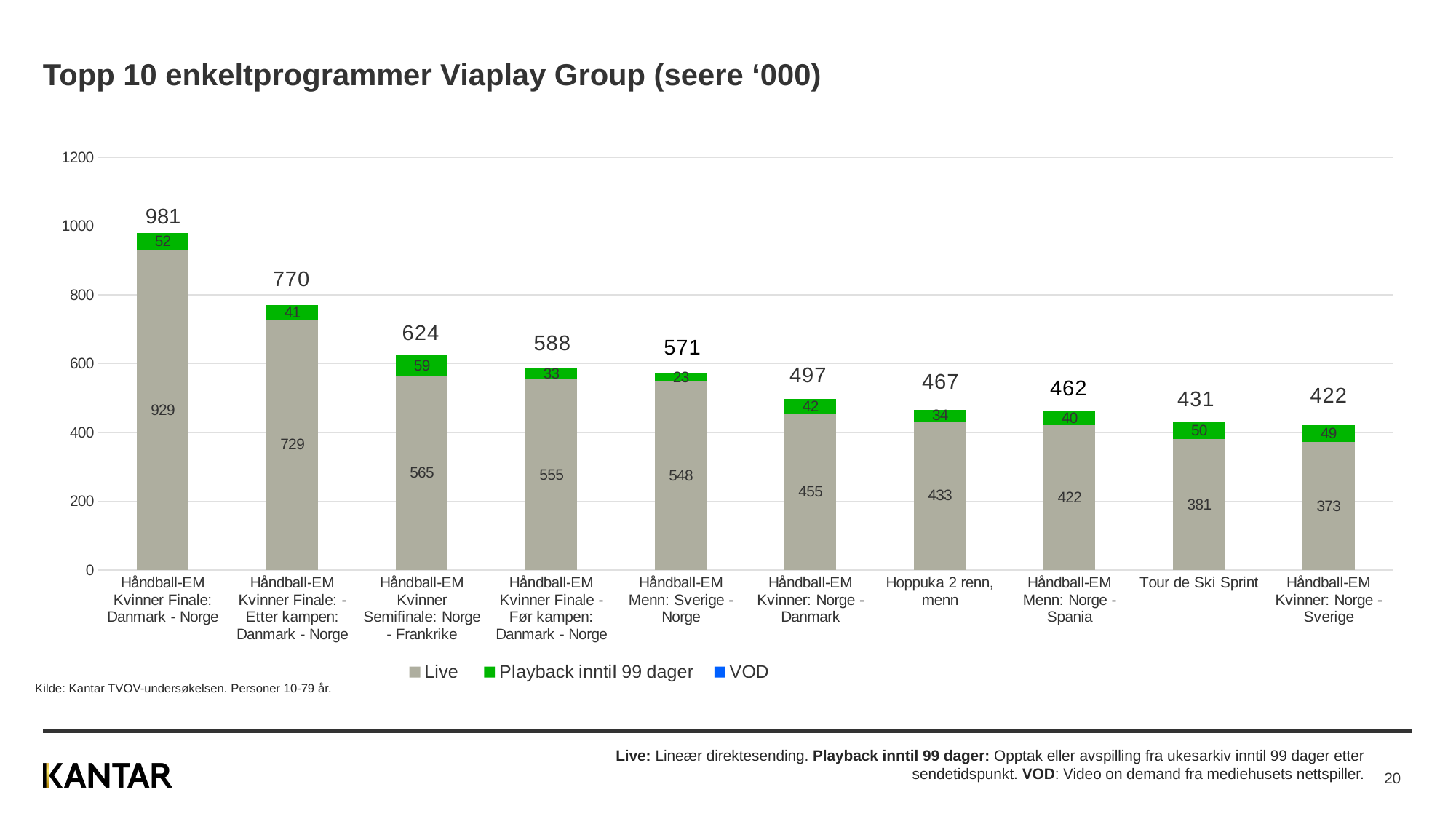
What kind of chart is shown on the slide? Stacked bar chart Which programme has the highest total viewers? Håndball-EM Kvinner Finale: Danmark - Norge What is the difference between the totals for Håndball-EM Kvinner Finale: Danmark - Norge and Håndball-EM Kvinner Finale: - Etter kampen: Danmark - Norge? 211 What is the Live value for Håndball-EM Kvinner Finale: Danmark - Norge? 929 How many series does the legend list? 3 What is the Playback inntil 99 dager value for Håndball-EM Kvinner Semifinale: Norge - Frankrike? 59 Is the total for Håndball-EM Menn: Sverige - Norge greater or less than 600? less Do the total values rise or fall from left to right along the x axis? fall Which programme has the lowest total viewers? Håndball-EM Kvinner: Norge - Sverige What is the total shown above the bar for Tour de Ski Sprint? 431 How many programmes are shown on the chart? 10 Which has a larger Live value: Hoppuka 2 renn, menn or Håndball-EM Menn: Norge - Spania? Hoppuka 2 renn, menn